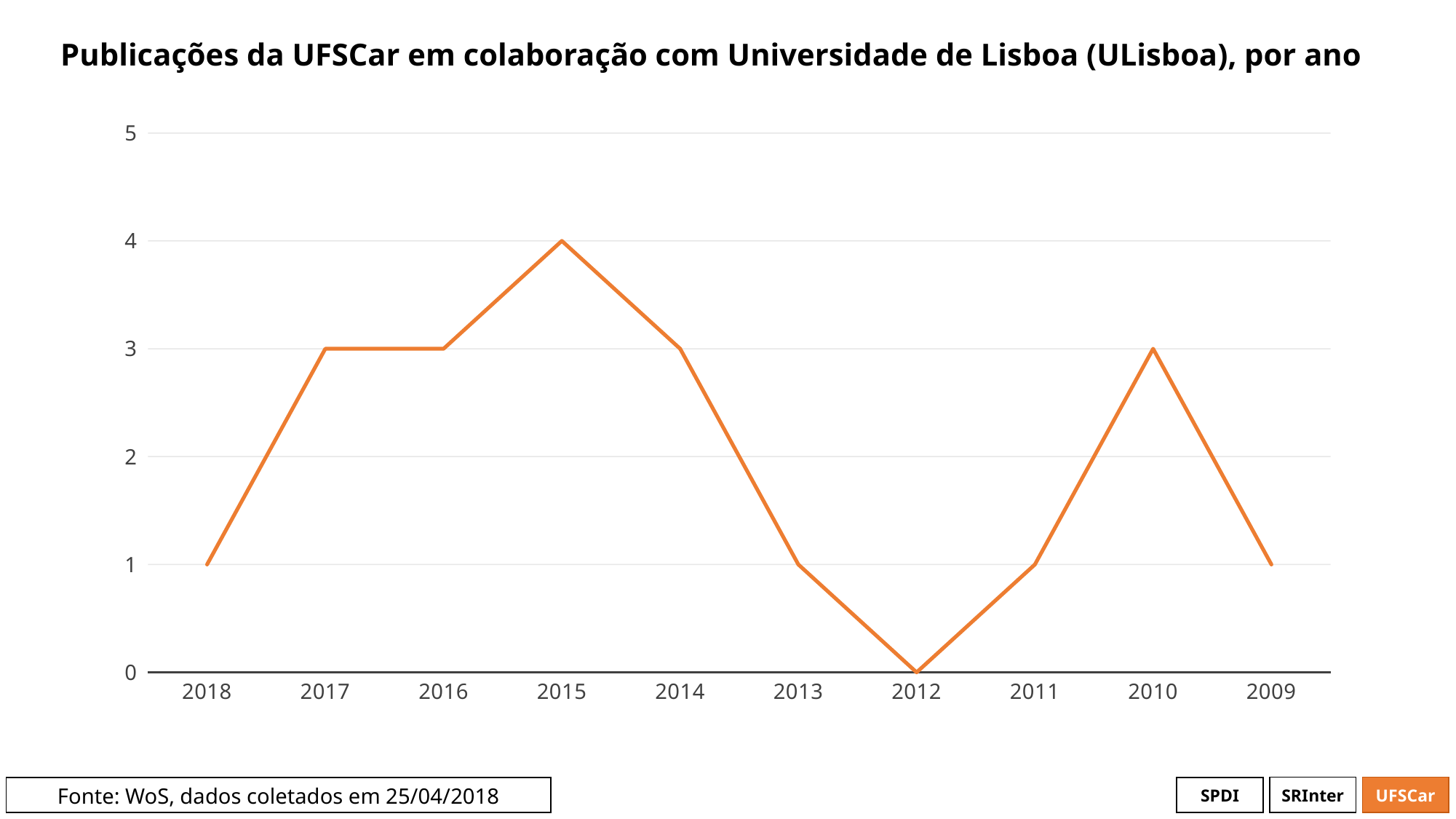
What is the value for 2012? 0 How many years are plotted on the x axis? 10 What is the value for 2018? 1 Which is larger, the value for 2014 or the value for 2011? 2014 Which year has the lowest value? 2012 What is the difference between the values for 2015 and 2013? 3 What kind of chart is shown on the slide? line chart What is the value for 2010? 3 What is the title of the chart? Publicações da UFSCar em colaboração com Universidade de Lisboa (ULisboa), por ano What is the value for 2015? 4 Which year has the highest value? 2015 Do the values rise or fall from 2012 to 2010 along the x axis? rise